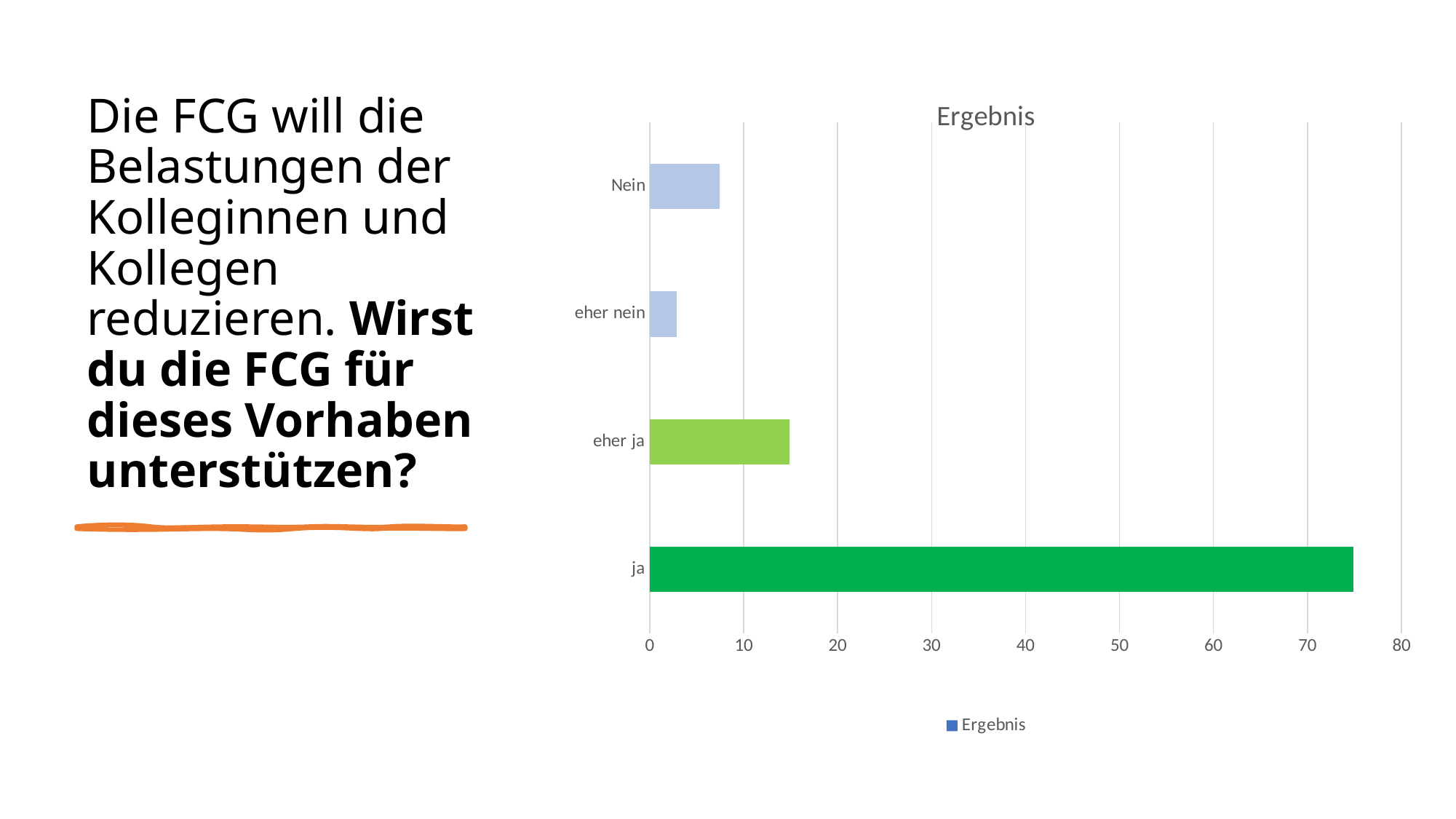
Which is larger, the value for eher ja or the value for Nein? eher ja Is the value for Nein greater or less than 10? less Is the value for eher ja greater or less than 10? greater Is the value for eher nein greater or less than 10? less Which category has the highest value? ja How many categories does the chart show? 4 What kind of chart is shown on the slide? bar chart Which category has the lowest value? eher nein How many series does the legend list? 1 What is the title of the chart? Ergebnis What is the name of the series shown in the legend? Ergebnis